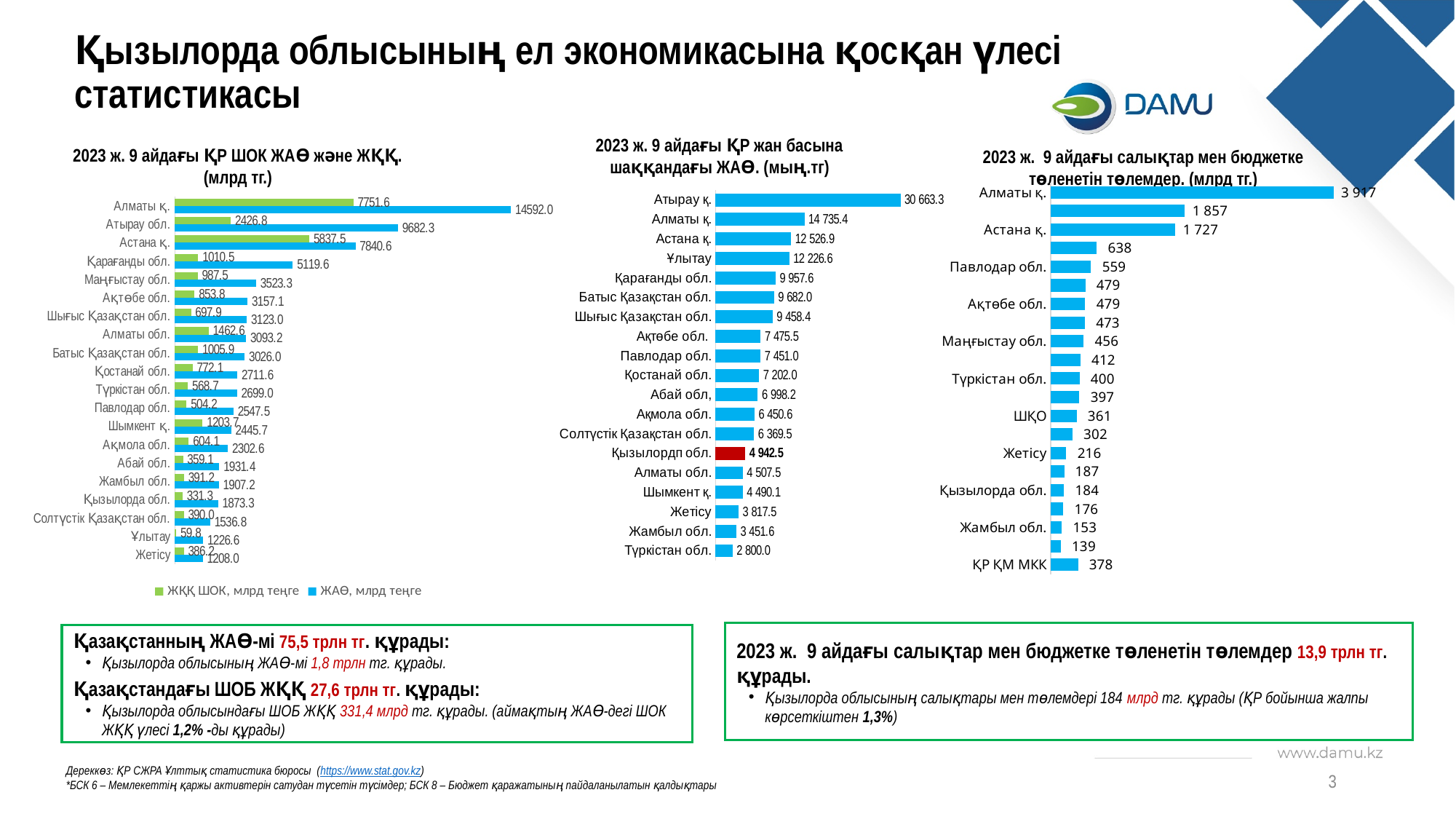
In the left chart (2023 ж. 9 айдағы ҚР ШОК ЖАӨ және ЖҚҚ), which category has the lowest ЖҚҚ ШОК value? Ұлытау In the middle chart (2023 ж. 9 айдағы ҚР жан басына шаққандағы ЖАӨ), what is the value for Қызылорда обл.? 4 942.5 In the right chart (2023 ж. 9 айдағы салықтар мен бюджетке төленетін төлемдер), what is the value for Алматы қ.? 3 917 In the left chart (2023 ж. 9 айдағы ҚР ШОК ЖАӨ және ЖҚҚ), how many series does the legend list? 2 In the left chart (2023 ж. 9 айдағы ҚР ШОК ЖАӨ және ЖҚҚ), what is the ЖАӨ value for Алматы қ.? 14592.0 In the middle chart (2023 ж. 9 айдағы ҚР жан басына шаққандағы ЖАӨ), which category has the lowest value? Түркістан обл. In the left chart (2023 ж. 9 айдағы ҚР ШОК ЖАӨ және ЖҚҚ), what is the difference between the ЖАӨ values of Атырау обл. and Астана қ.? 1841.7 In the left chart (2023 ж. 9 айдағы ҚР ШОК ЖАӨ және ЖҚҚ), what is the ЖҚҚ ШОК value for Қызылорда обл.? 331.3 What kind of chart is the right chart (2023 ж. 9 айдағы салықтар мен бюджетке төленетін төлемдер)? Bar chart In the middle chart (2023 ж. 9 айдағы ҚР жан басына шаққандағы ЖАӨ), which category has the highest value? Атырау қ. In the middle chart (2023 ж. 9 айдағы ҚР жан басына шаққандағы ЖАӨ), how many categories are plotted? 19 In the right chart (2023 ж. 9 айдағы салықтар мен бюджетке төленетін төлемдер), which is larger: Павлодар обл. or Жамбыл обл.? Павлодар обл.